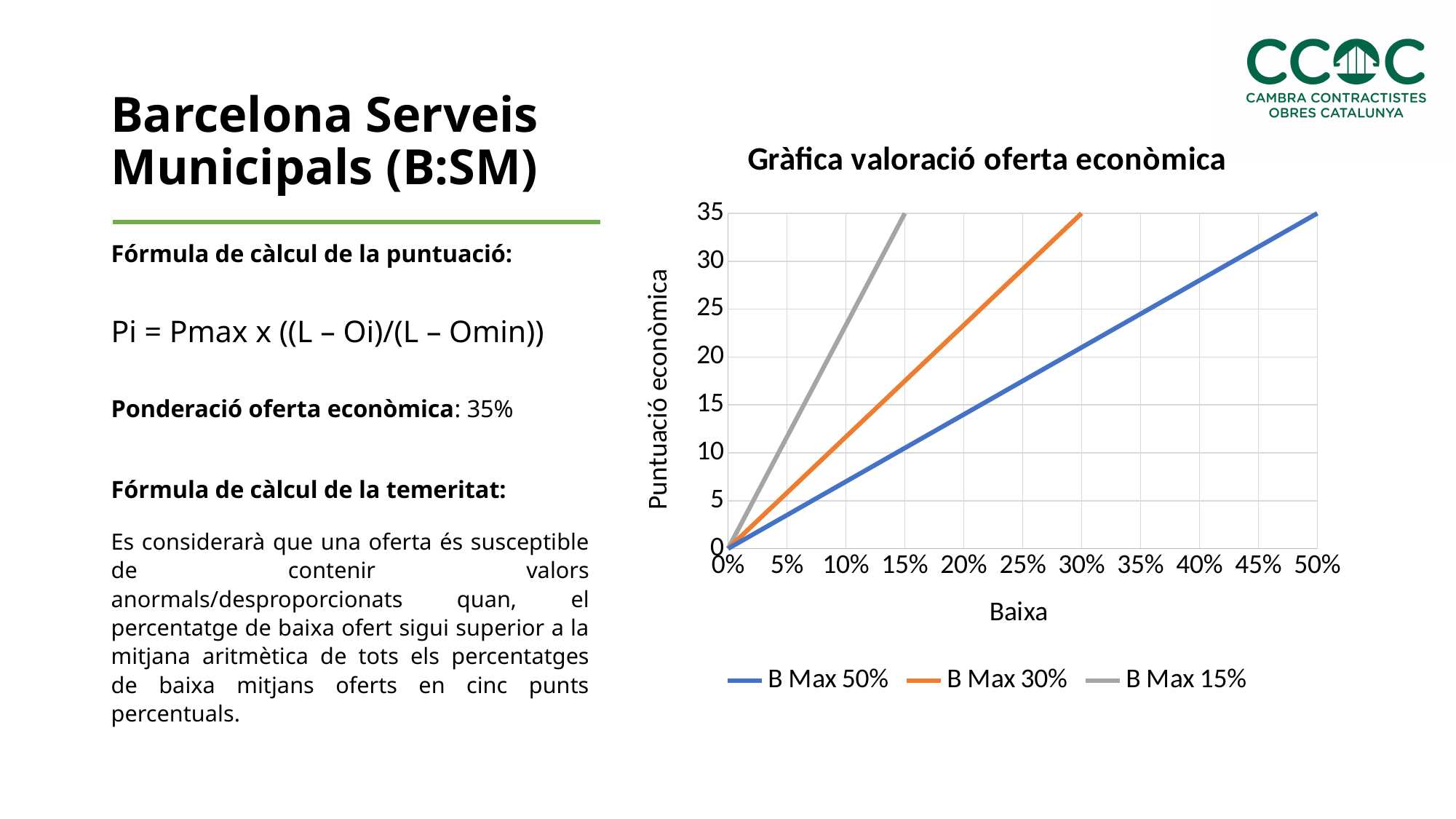
Which series reaches a Puntuació econòmica of 35 at the smallest Baixa? B Max 15% What is the Puntuació econòmica for the B Max 15% series at a Baixa of 15%? 35 What kind of chart is shown on the slide? line chart Do the values of the B Max 50% series rise or fall as Baixa increases? rise What is the title of the chart? Gràfica valoració oferta econòmica At a Baixa of 10%, which series has the higher Puntuació econòmica, B Max 15% or B Max 50%? B Max 15% Is the value for the B Max 15% series at a Baixa of 10% greater or less than 20? greater What is the Puntuació econòmica for the B Max 30% series at a Baixa of 30%? 35 What is the Puntuació econòmica for the B Max 50% series at a Baixa of 50%? 35 Is the value for the B Max 50% series at a Baixa of 25% greater or less than 20? less How many series does the legend of the chart list? 3 What colour is the B Max 30% line in the chart? orange